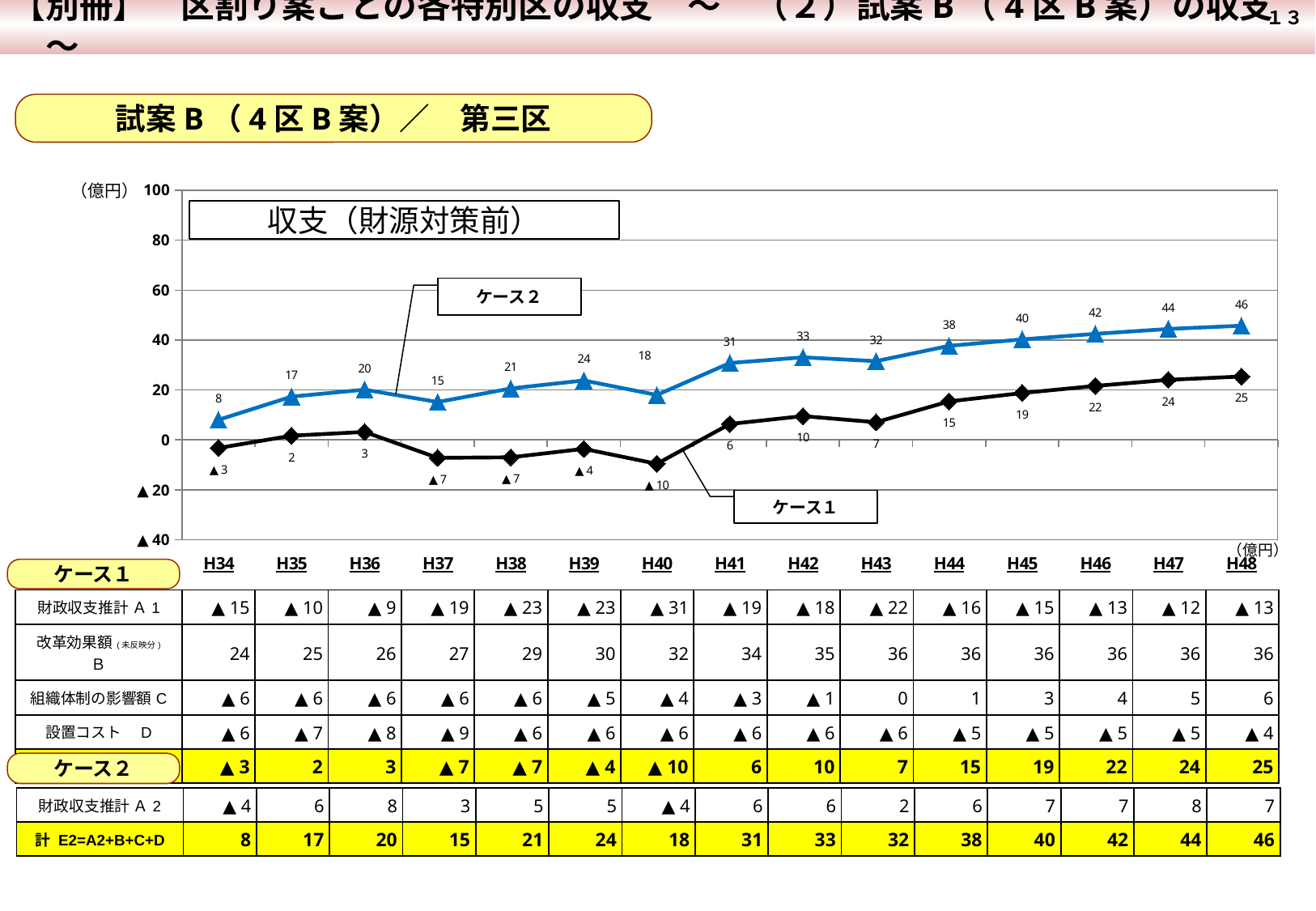
What type of chart is shown on the slide? line chart What is the value of ケース1 at H45? 19 How many years are plotted on the x axis? 15 What is the title shown inside the chart area? 収支（財源対策前） What is the difference between ケース2 and ケース1 at H48? 21 What is the value of ケース1 at H40? ▲10 At which year does ケース2 reach its highest value? H48 Does ケース2 generally rise or fall from H41 to H48? rise What is the value of ケース2 at H34? 8 Which series has the higher value at H42, ケース1 or ケース2? ケース2 At which year is ケース1 at its lowest value? H40 What is the value of ケース2 at H48? 46